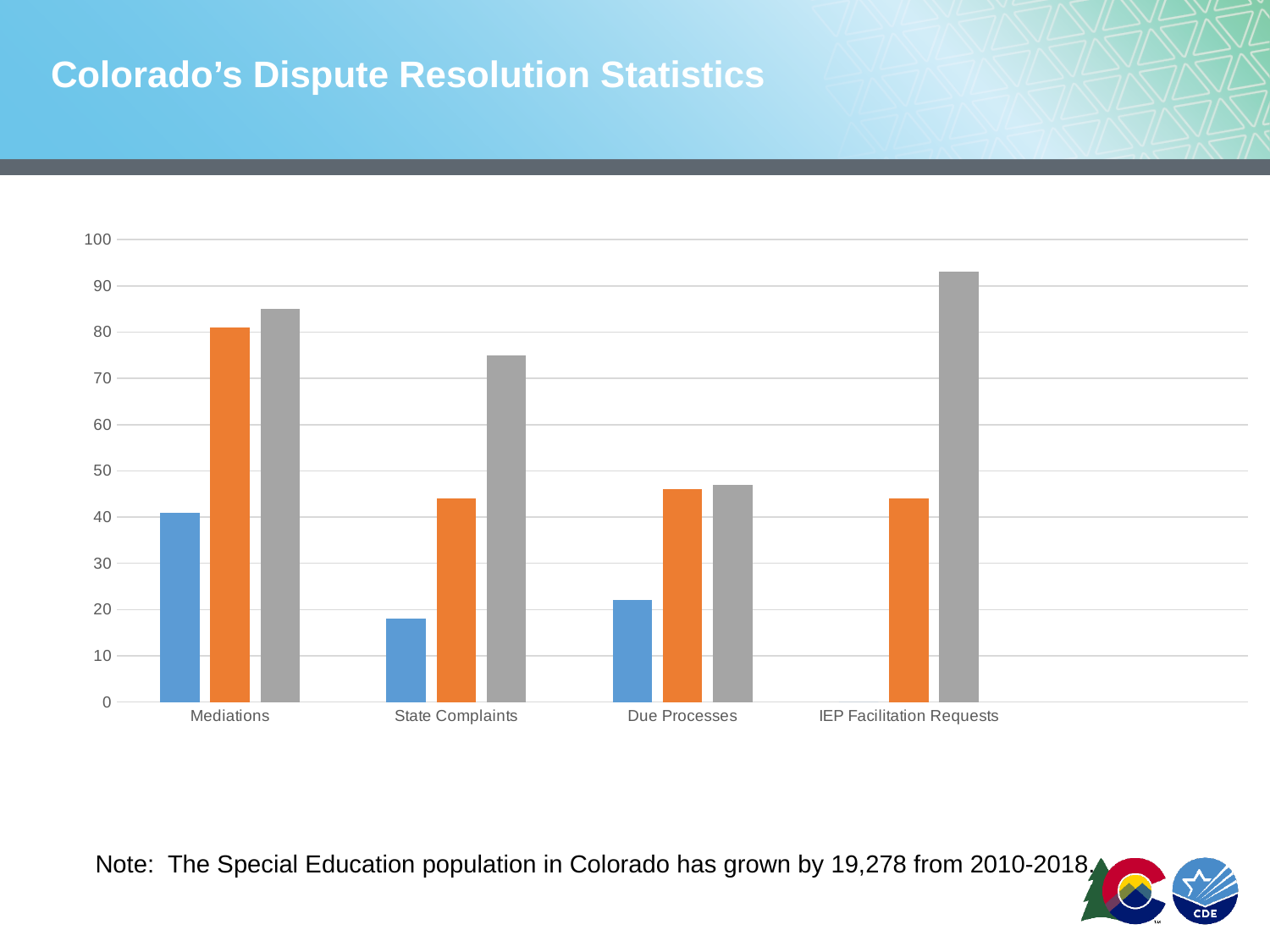
Is the gray bar for IEP Facilitation Requests greater or less than 80? greater Which category has no blue bar? IEP Facilitation Requests What kind of chart is shown on the slide? bar chart Which category has the tallest gray bar? IEP Facilitation Requests Is the blue bar for Mediations greater or less than 50? less How many categories are shown on the x axis of the chart? 4 Is the orange bar for Mediations greater or less than 70? greater What is the title of the slide containing the chart? Colorado's Dispute Resolution Statistics Which is larger, the orange bar for Mediations or the orange bar for State Complaints? Mediations Which is larger, the gray bar for State Complaints or the gray bar for Due Processes? State Complaints